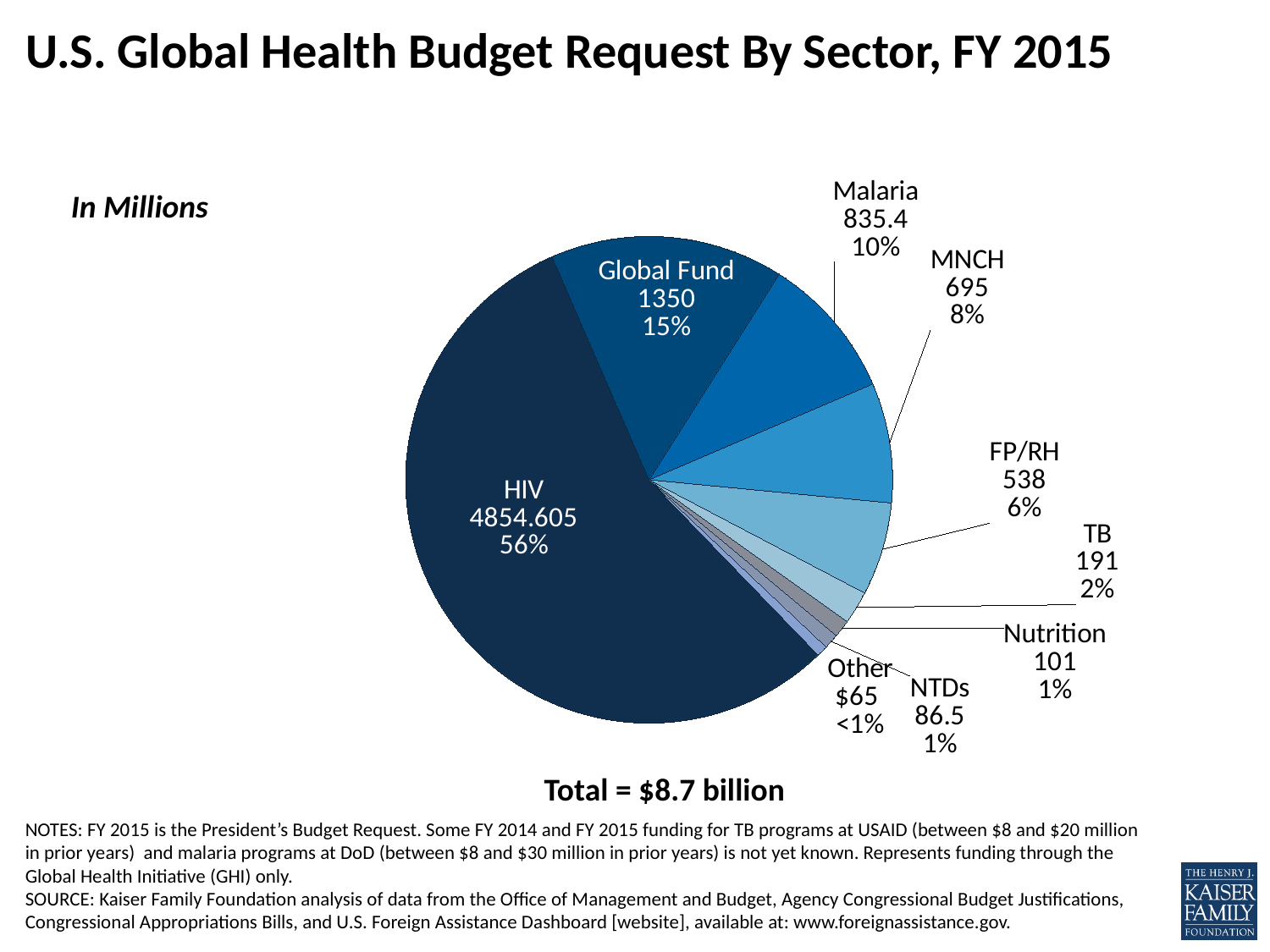
What is the value for HIV in the pie chart? 4854.605 What is the value for Malaria? 835.4 What is the value for Global Fund? 1350 How many sectors are shown in the pie chart? 9 What share of the pie does MNCH represent? 8% What is the difference between the values for Global Fund and Malaria? 514.6 Which is larger, the value for FP/RH or the value for TB? FP/RH What total is stated below the pie chart? Total = $8.7 billion What share of the pie does HIV represent? 56% Which sector has the largest slice of the pie? HIV Which sector has the smallest slice of the pie? Other What type of chart is shown on the slide? pie chart